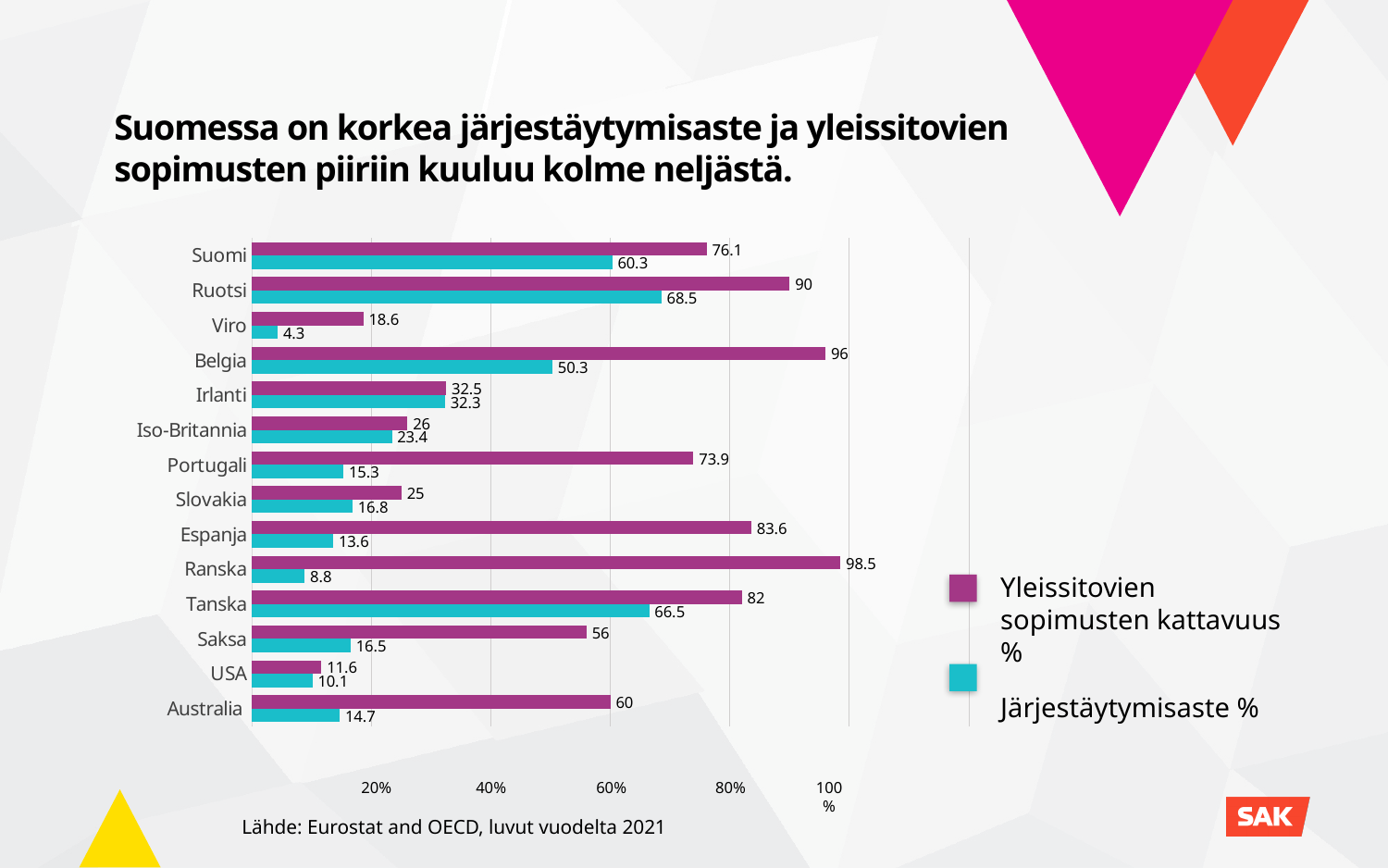
What is the value of Järjestäytymisaste % for Ruotsi? 68.5 Is the Yleissitovien sopimusten kattavuus % for Espanja greater or less than 80%? greater Which country has the lowest value for Järjestäytymisaste %? Viro How many countries are shown in the chart? 14 How many series does the legend list? 2 Which country has the highest value for Järjestäytymisaste %? Ruotsi Which is larger: the Yleissitovien sopimusten kattavuus % for Belgia or for Tanska? Belgia What is the value of Järjestäytymisaste % for Viro? 4.3 What is the difference between Yleissitovien sopimusten kattavuus % and Järjestäytymisaste % for Suomi? 15.8 Which country has the highest value for Yleissitovien sopimusten kattavuus %? Ranska What is the value of Yleissitovien sopimusten kattavuus % for Suomi? 76.1 What kind of chart is shown on the slide? Bar chart